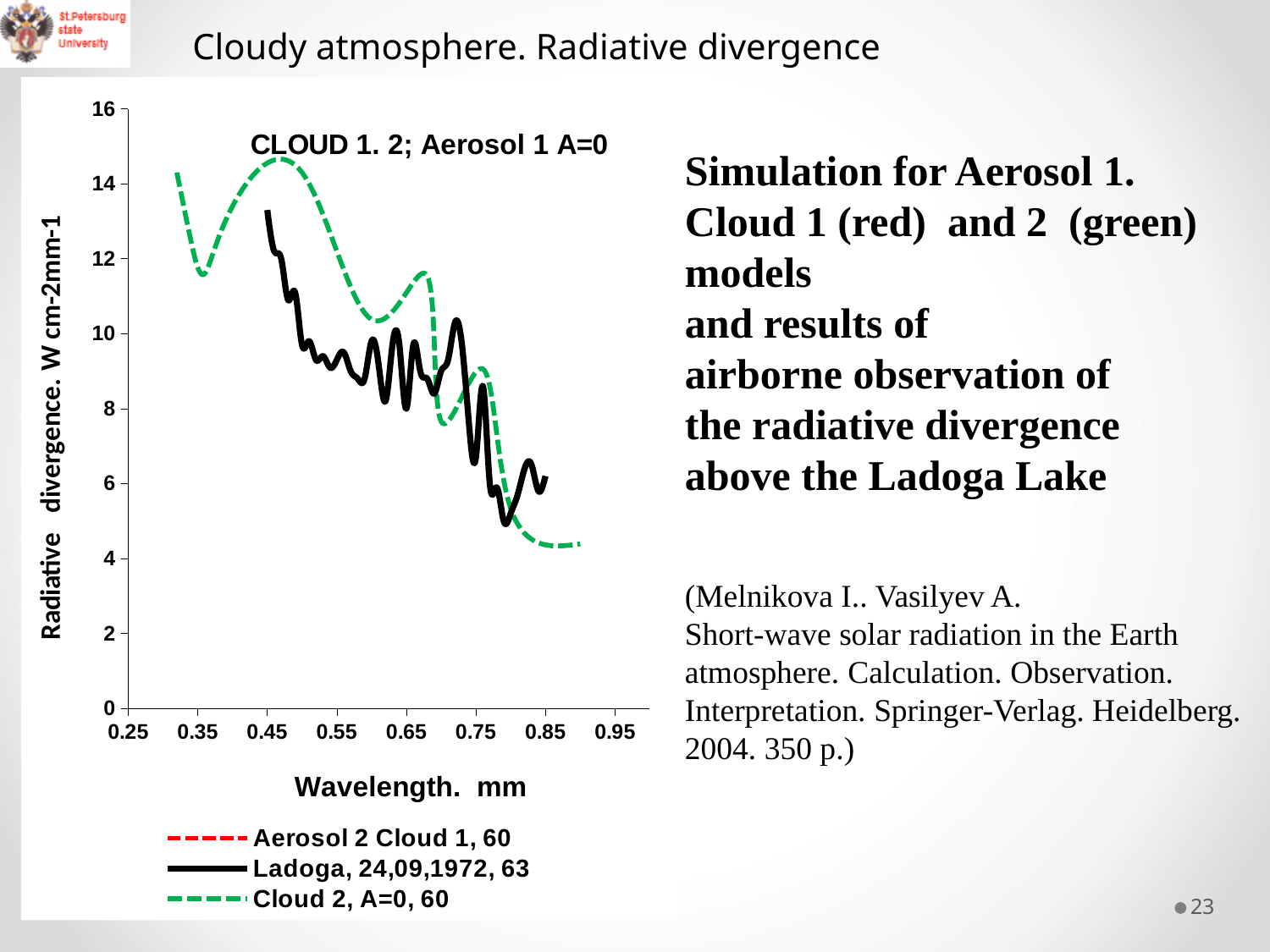
What is the title printed inside the chart? CLOUD 1. 2; Aerosol 1 A=0 Is the value of the Cloud 2, A=0, 60 series at wavelength 0.9 greater or less than 6? less Is the value of the Ladoga, 24,09,1972, 63 series at wavelength 0.45 greater or less than 12? greater What is the label of the x axis of the chart? Wavelength. mm What kind of chart is shown on the slide? Line chart Overall, does the Cloud 2, A=0, 60 series rise or fall as wavelength increases from 0.45 to 0.9? Fall Is the value of the Cloud 2, A=0, 60 series at wavelength 0.45 greater or less than 12? greater How many series does the chart legend list? 3 At wavelength 0.55, which series has the larger value: Cloud 2, A=0, 60 or Ladoga, 24,09,1972, 63? Cloud 2, A=0, 60 At wavelength 0.85, which series has the larger value: Cloud 2, A=0, 60 or Ladoga, 24,09,1972, 63? Ladoga, 24,09,1972, 63 Overall, does the Ladoga, 24,09,1972, 63 series rise or fall as wavelength increases from 0.45 to 0.85? Fall